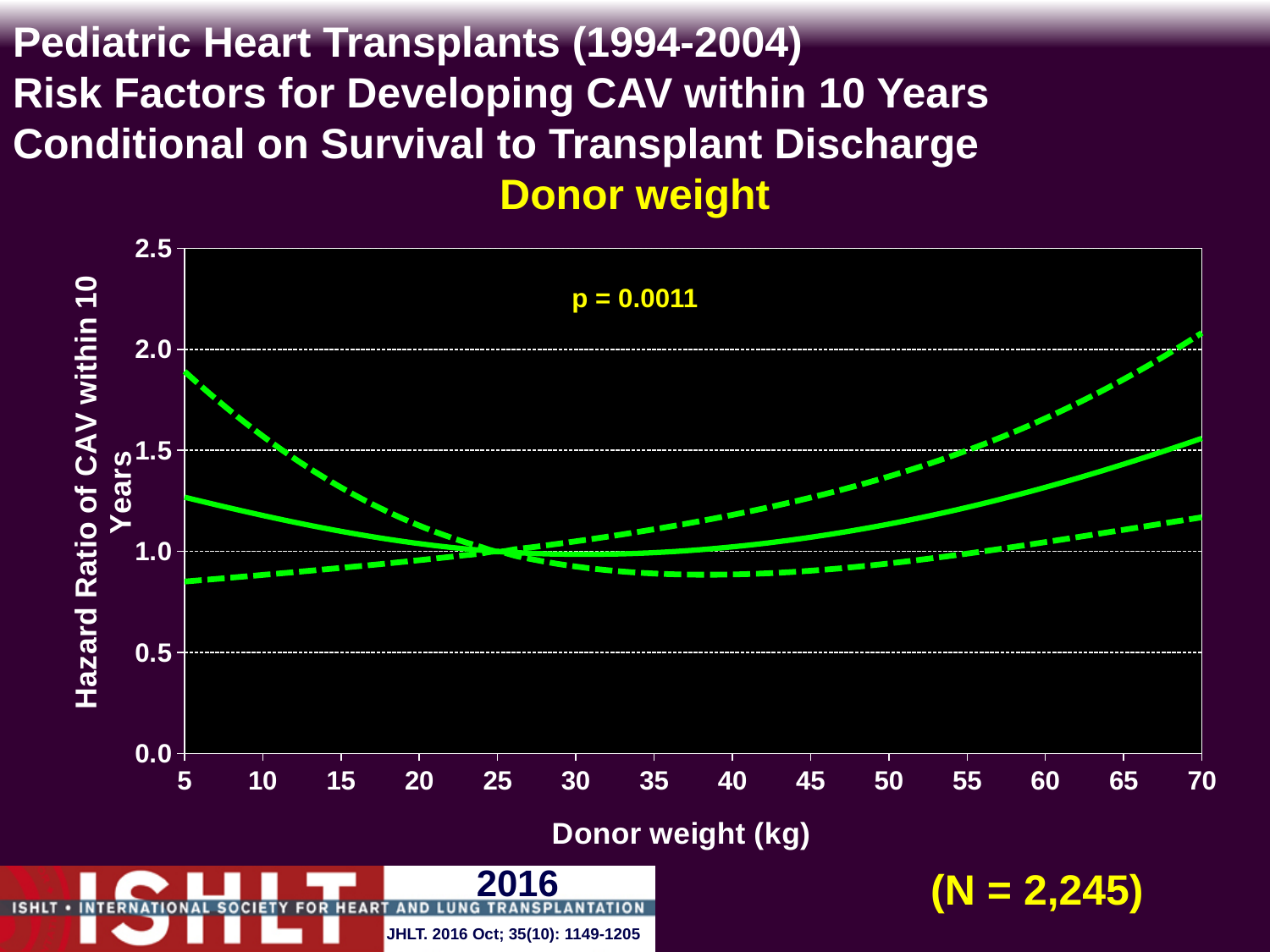
Is the hazard ratio on the solid line at a donor weight of 5 kg greater or less than 1.5? less How many lines are plotted on the chart? 3 Does the solid line rise or fall as donor weight increases from 45 kg to 70 kg? rise What kind of chart is shown on the slide? line chart How many tick labels are shown on the x axis (Donor weight)? 14 What is the sample size (N) shown on the slide? N = 2,245 What is the p-value printed on the chart? p = 0.0011 Is the lower dashed line at a donor weight of 70 kg greater or less than 1.0? greater Is the upper dashed line at a donor weight of 5 kg greater or less than 2.0? less Does the solid line rise or fall as donor weight increases from 5 kg to 25 kg? fall